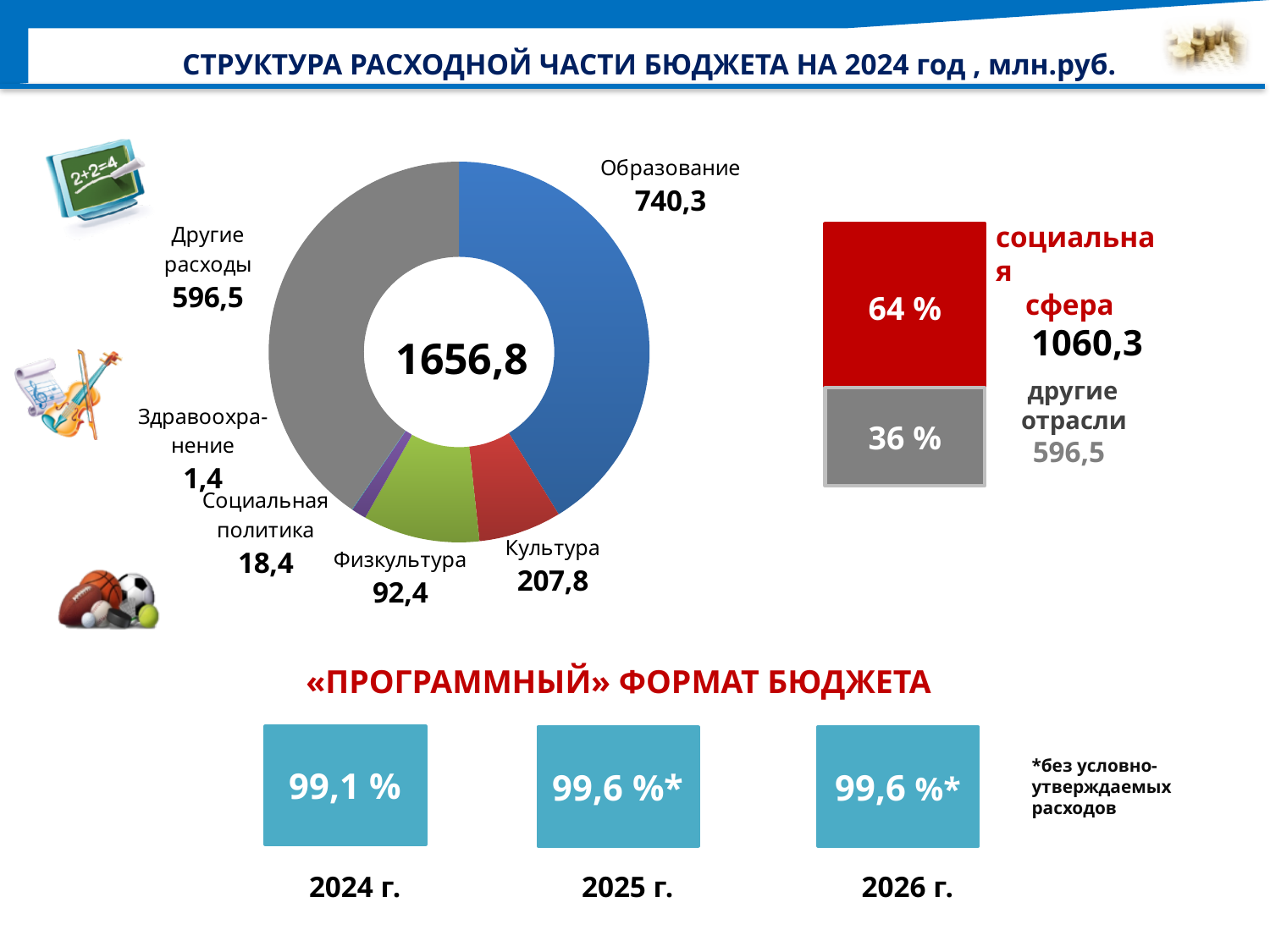
What total value is shown in the centre of the donut chart? 1656,8 In the donut chart, which category has the lowest value? Здравоохранение In the donut chart, what is the value for Социальная политика? 18,4 In the donut chart, which category has the highest value? Образование What kind of chart is used to show the structure of budget expenditures for 2024? Donut (pie) chart In the donut chart, which is larger: Культура or Физкультура? Культура In the donut chart, what is the value for Здравоохранение? 1,4 In the donut chart, what is the difference between Образование and Другие расходы? 143,8 How many categories are shown in the donut chart? 6 In the donut chart, what is the value for Физкультура? 92,4 In the donut chart, what is the value for Образование? 740,3 In the donut chart, what is the value for Культура? 207,8